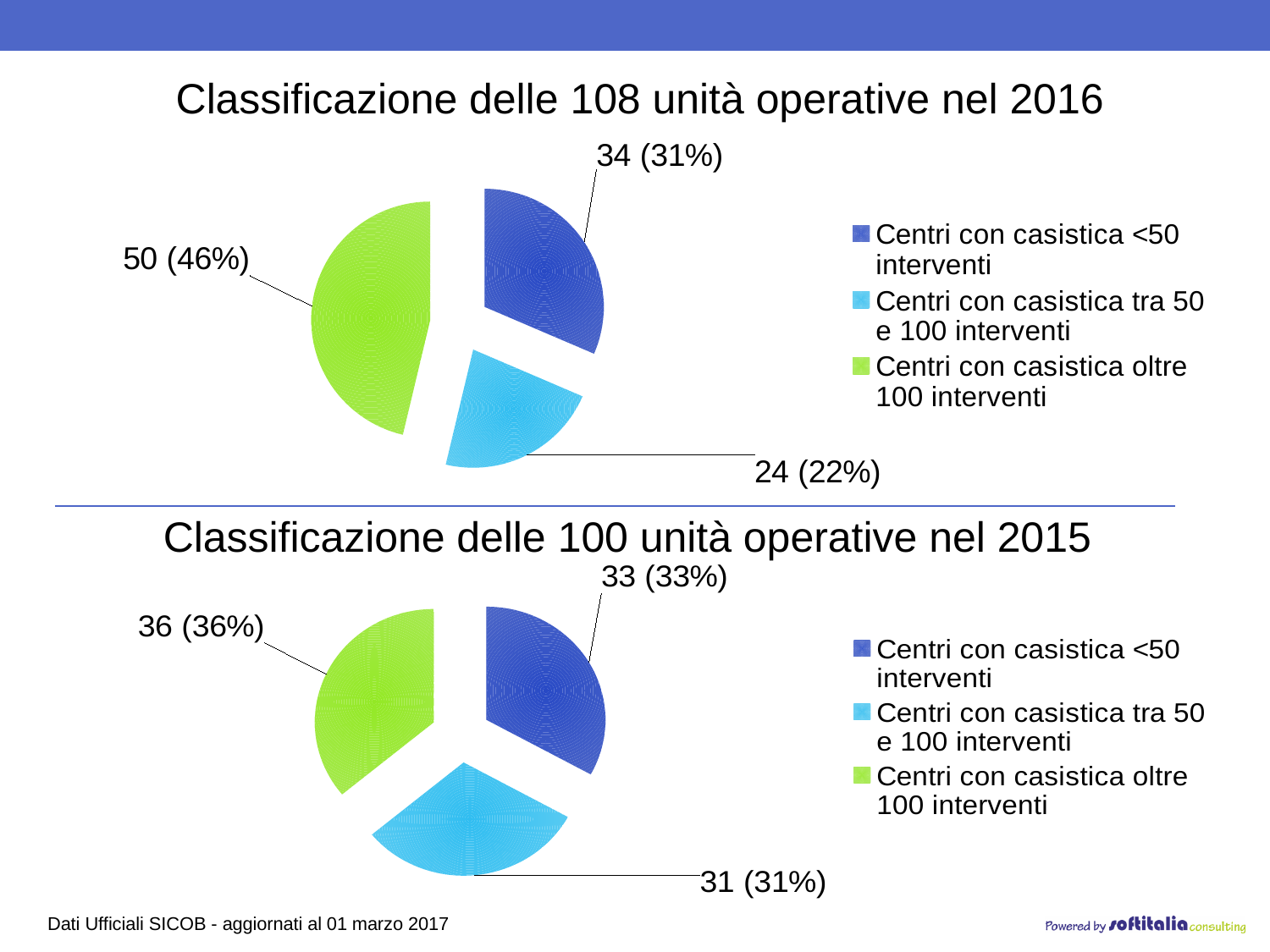
In the 2015 chart (bottom), what colour is the slice for 'Centri con casistica <50 interventi'? Blue In the 2015 chart (bottom), which category has the largest slice? Centri con casistica oltre 100 interventi In the 2015 chart (bottom), what share of the pie is 'Centri con casistica oltre 100 interventi'? 36% In the 2015 chart (bottom), what is the difference between the number of centres with over 100 interventions and those with between 50 and 100? 5 How many categories does the legend of the 2016 chart (top) list? 3 In the 2016 chart (top), what is the difference between the number of centres with over 100 interventions and those with fewer than 50? 16 In the 2016 chart (top), which category has the smallest slice? Centri con casistica tra 50 e 100 interventi In the 2016 chart (top), which category has the largest slice? Centri con casistica oltre 100 interventi In the 2016 chart (top), how many centres have a caseload of over 100 interventions? 50 In the 2016 chart (top), what share of the pie is 'Centri con casistica tra 50 e 100 interventi'? 22% What type of chart is used on this slide? Pie chart In the 2015 chart (bottom), how many centres have a caseload between 50 and 100 interventions? 31